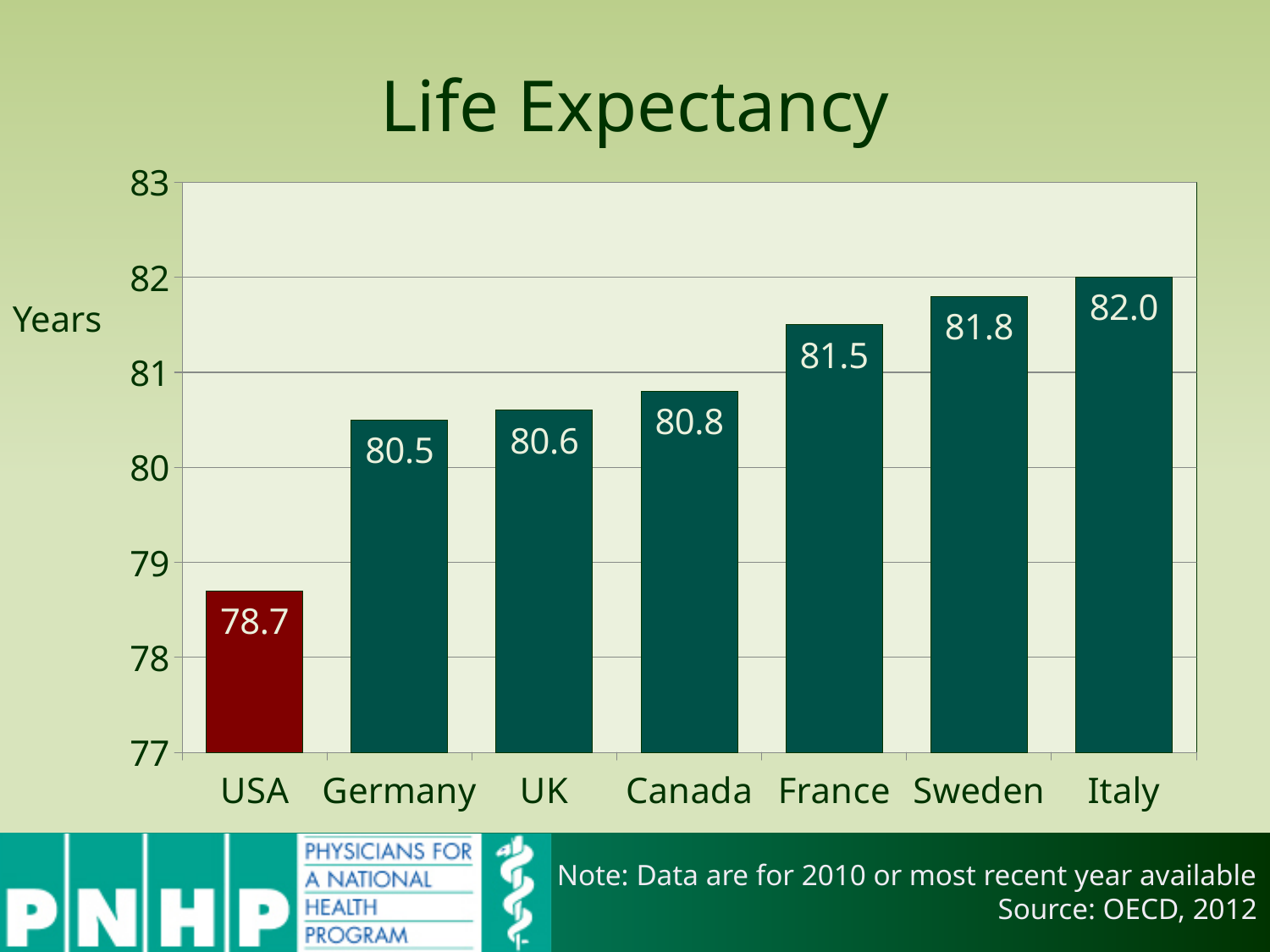
What is the difference in life expectancy between Sweden and Germany? 1.3 Which country has the lowest life expectancy on the chart? USA What kind of chart is shown on the slide? bar chart What is the life expectancy value shown for the USA? 78.7 What is the life expectancy value shown for Canada? 80.8 What is the difference in life expectancy between Italy and the USA? 3.3 Is the value for the USA greater or less than 79? less What is the title of the chart? Life Expectancy How many countries are shown on the chart? 7 What is the life expectancy value shown for France? 81.5 Which has a higher life expectancy, Canada or France? France Which country has the highest life expectancy on the chart? Italy